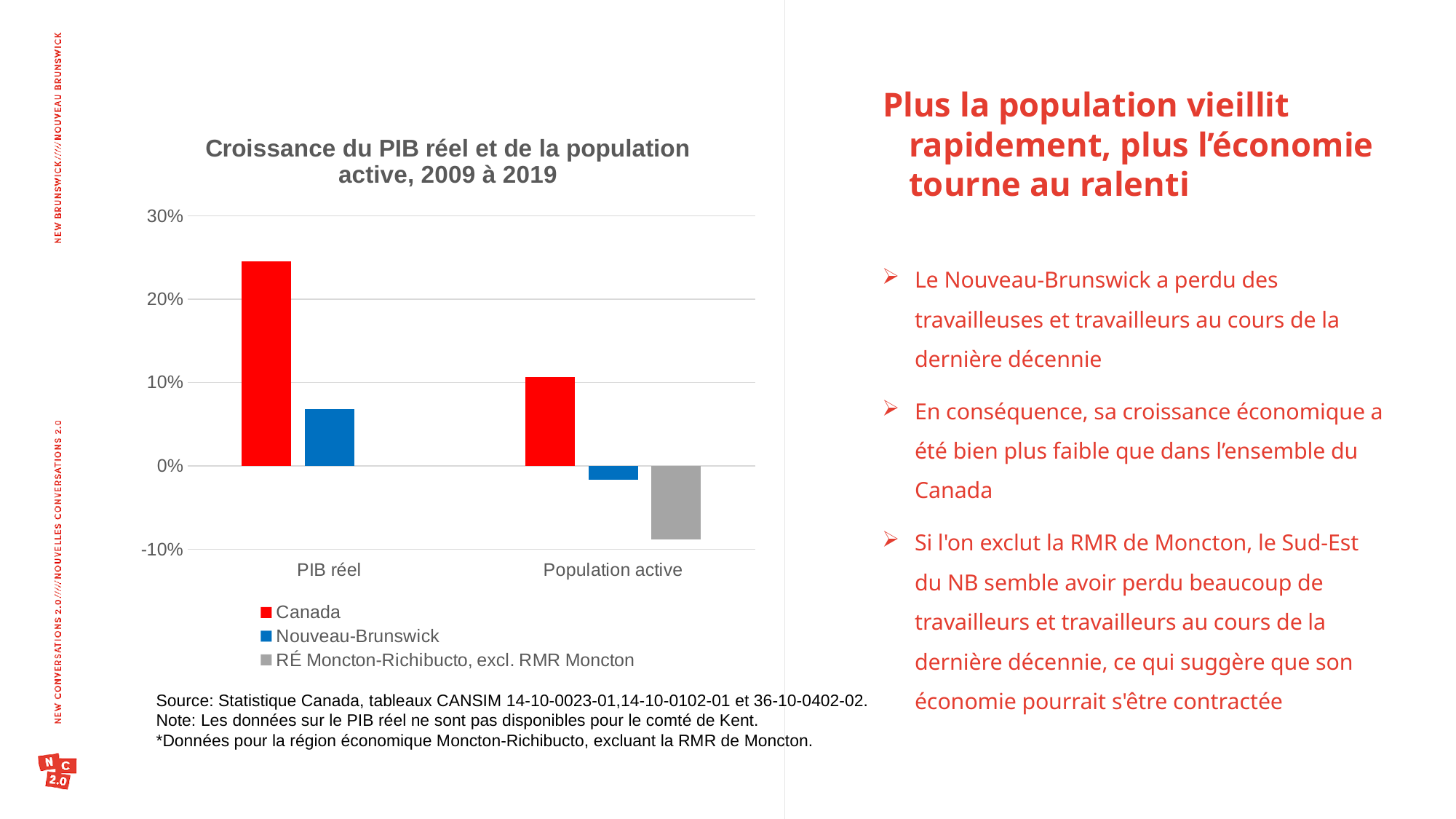
Is the value for Canada in PIB réel greater or less than 20%? greater Is the value for Nouveau-Brunswick in Population active greater or less than 0%? less What colour represents Canada in the chart? red Which series has the highest value for PIB réel? Canada What kind of chart is shown on the slide? bar chart How many series does the legend list? 3 Is the value for Nouveau-Brunswick in PIB réel greater or less than 10%? less Which is larger: the Nouveau-Brunswick value for Population active or the RÉ Moncton-Richibucto, excl. RMR Moncton value for Population active? Nouveau-Brunswick How many categories are shown on the x axis? 2 Which is larger: the Canada value for PIB réel or the Canada value for Population active? PIB réel Which series has the lowest value for Population active? RÉ Moncton-Richibucto, excl. RMR Moncton